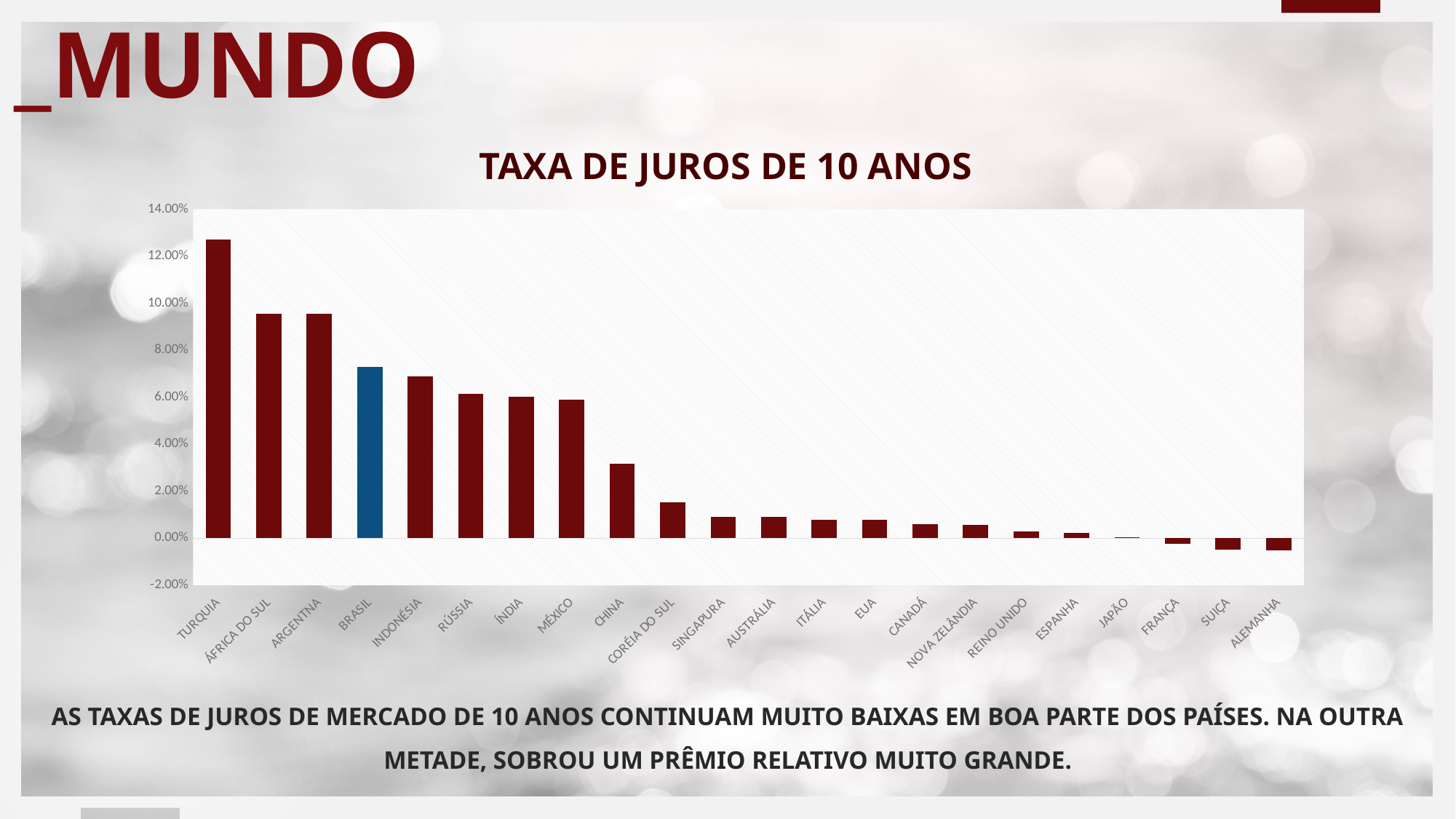
How many countries are shown on the x axis of the chart? 22 Which country has the highest 10-year interest rate in the chart? Turquia Is the value for China greater or less than 4.00%? less Which country's bar is coloured blue instead of dark red? Brasil What is the title of the chart? TAXA DE JUROS DE 10 ANOS What kind of chart is shown on the slide? bar chart Is the value for Coréia do Sul greater or less than 2.00%? less Is the value for Turquia greater or less than 12.00%? greater Do the values rise or fall moving from left to right along the x axis? fall Which has the larger value, Brasil or Rússia? Brasil